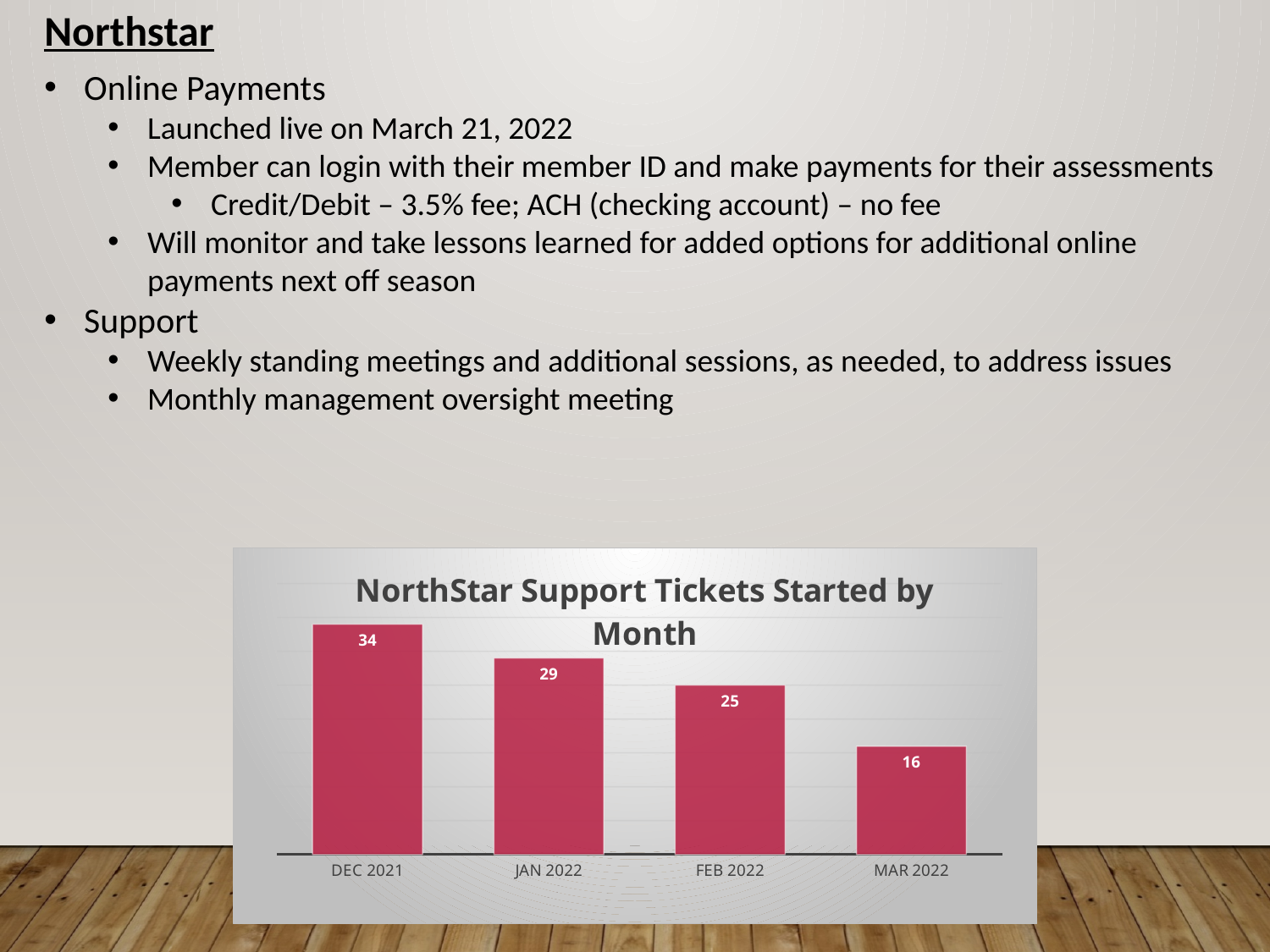
Which month has the lowest number of support tickets started? MAR 2022 What is the value for DEC 2021 in the NorthStar Support Tickets Started by Month chart? 34 Which month has the highest number of support tickets started? DEC 2021 Which is larger, the value for JAN 2022 or the value for FEB 2022? JAN 2022 Do the values rise or fall from DEC 2021 to MAR 2022? Fall How many support tickets were started in JAN 2022? 29 How many months are shown in the chart? 4 What is the value shown for FEB 2022? 25 What is the value shown for MAR 2022? 16 What kind of chart is shown on the slide? Bar chart What is the difference between the DEC 2021 and MAR 2022 values? 18 What is the difference between the JAN 2022 and FEB 2022 values? 4